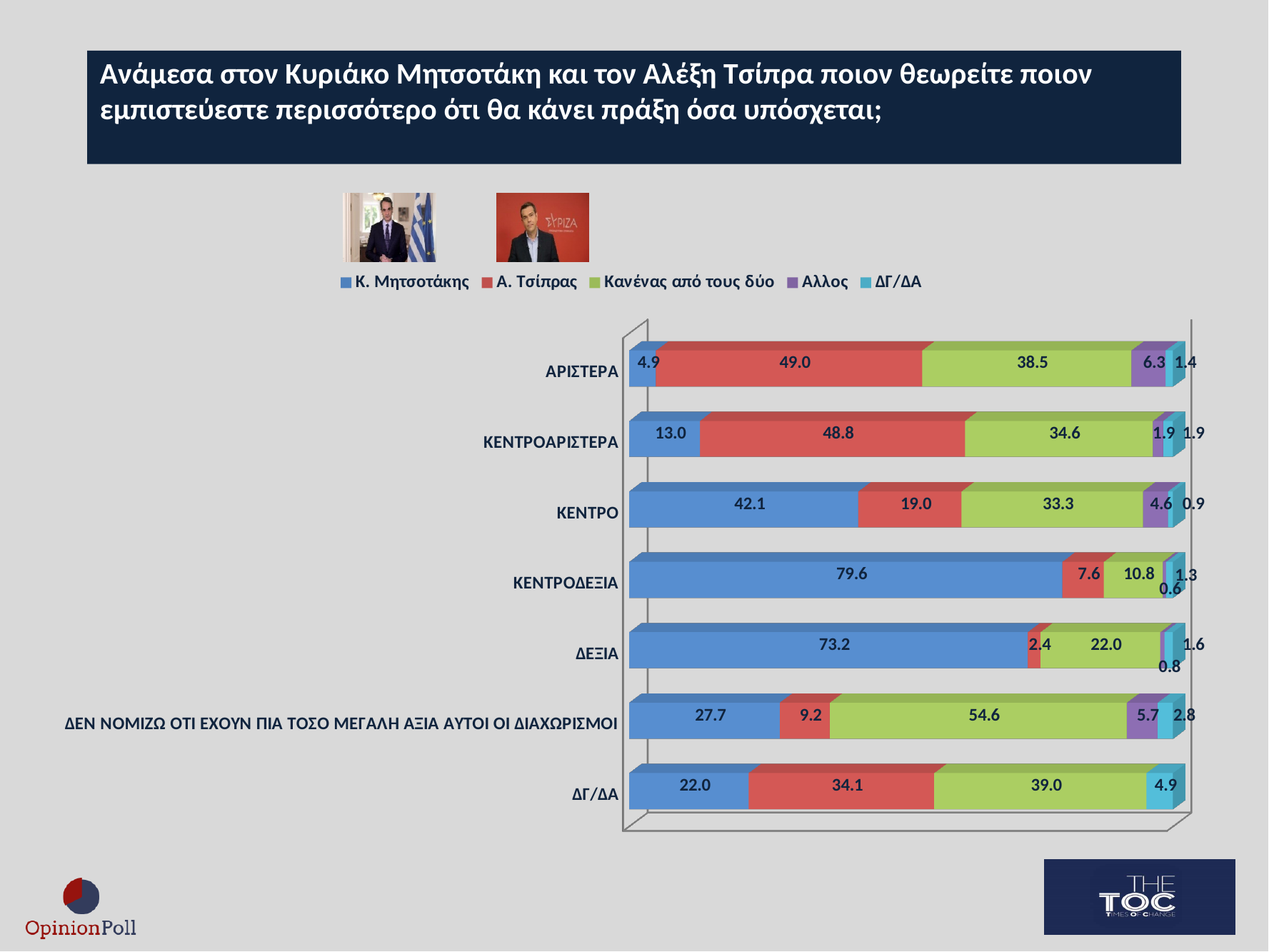
Which category has the lowest value for Κ. Μητσοτάκης? ΑΡΙΣΤΕΡΑ How many series does the legend list? 5 What is the difference between the Κ. Μητσοτάκης values for ΚΕΝΤΡΟΔΕΞΙΑ and ΔΕΞΙΑ? 6.4 Which category has the highest value for Κ. Μητσοτάκης? ΚΕΝΤΡΟΔΕΞΙΑ What kind of chart is shown on the slide? Stacked bar chart What is the value for Α. Τσίπρας in the ΑΡΙΣΤΕΡΑ category? 49.0 What is the value for ΔΓ/ΔΑ in the ΔΓ/ΔΑ category? 4.9 In the ΚΕΝΤΡΟ category, which is larger: the value for Κ. Μητσοτάκης or for Α. Τσίπρας? Κ. Μητσοτάκης What is the value for Κανένας από τους δύο in the ΔΕΝ ΝΟΜΙΖΩ ΟΤΙ ΕΧΟΥΝ ΠΙΑ ΤΟΣΟ ΜΕΓΑΛΗ ΑΞΙΑ ΑΥΤΟΙ ΟΙ ΔΙΑΧΩΡΙΣΜΟΙ category? 54.6 How many categories (bars) are shown in the chart? 7 What is the value for Κ. Μητσοτάκης in the ΚΕΝΤΡΟΔΕΞΙΑ category? 79.6 Which series is shown in green in the legend? Κανένας από τους δύο